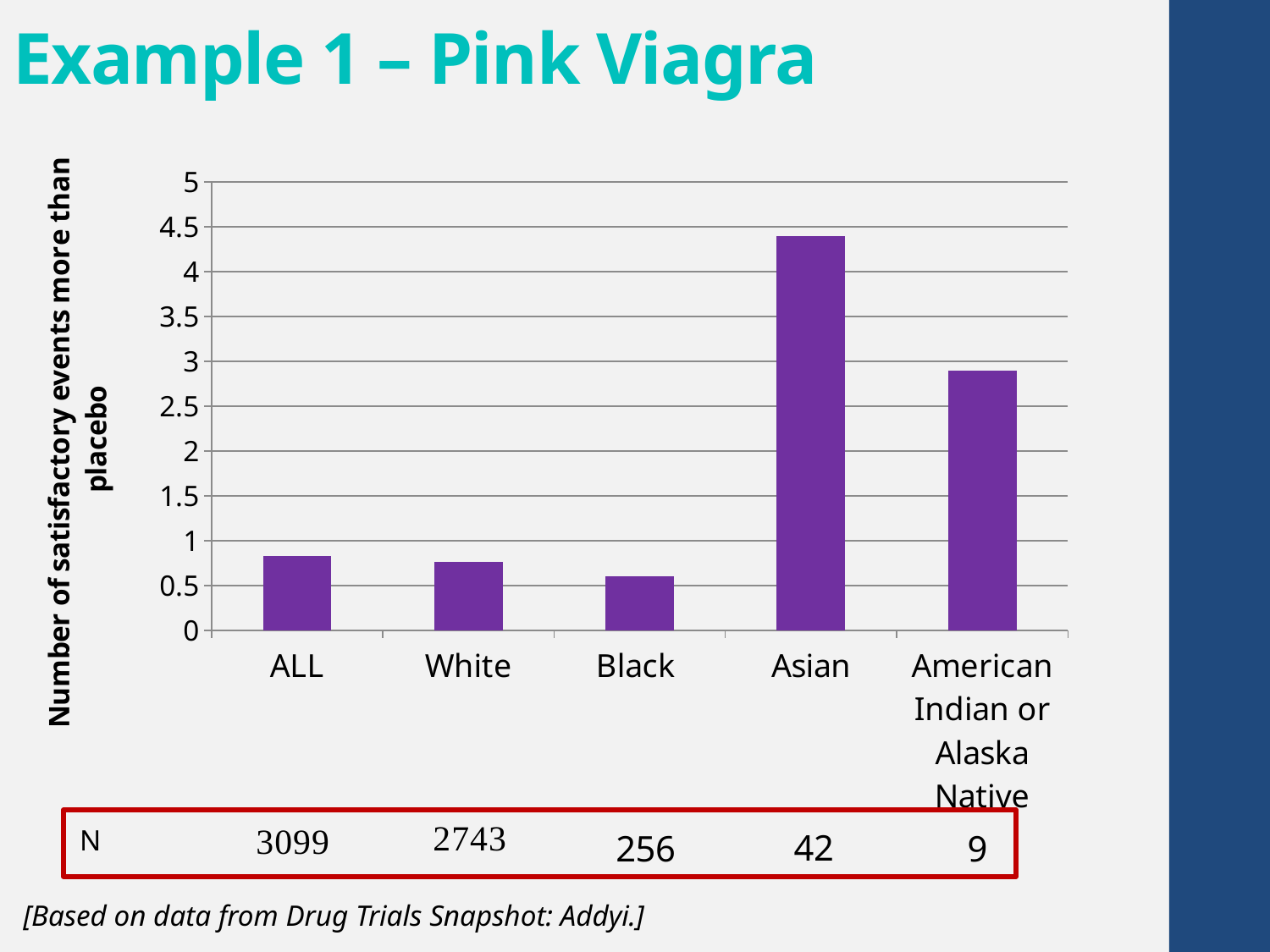
Is the value for Black greater or less than 1? less What is the N value shown for the Asian group in the table below the chart? 42 Which category has the lowest number of satisfactory events more than placebo? Black What kind of chart is shown on the slide? bar chart Is the value for American Indian or Alaska Native greater or less than 2.5? greater Which category has the highest number of satisfactory events more than placebo? Asian What is the title of the y axis of the chart? Number of satisfactory events more than placebo Which has a higher value, White or Black? White Is the value for ALL greater or less than 0.5? greater Which has a higher value, Asian or American Indian or Alaska Native? Asian How many categories are shown on the x axis of the chart? 5